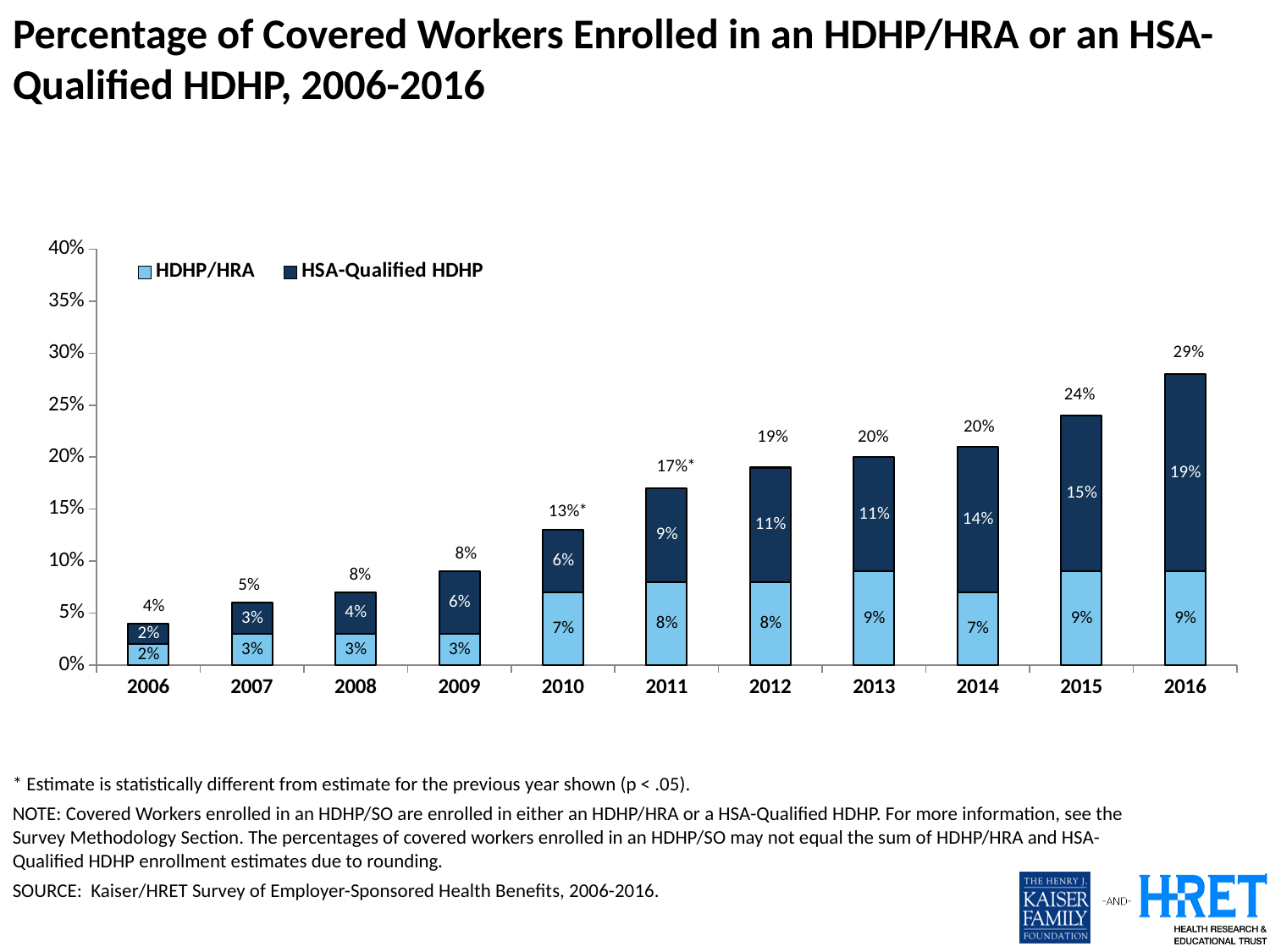
Which year has the lowest total enrollment? 2006 How many series does the legend list? 2 What is the HSA-Qualified HDHP value for 2016? 19% What is the difference between the HSA-Qualified HDHP value in 2016 and in 2015? 4% How many years are shown on the x axis? 11 Do the total enrollment values generally rise or fall from 2006 to 2016? rise What is the HDHP/HRA value for 2014? 7% In 2012, which is larger: the HDHP/HRA value or the HSA-Qualified HDHP value? HSA-Qualified HDHP Which year has the highest total enrollment? 2016 What type of chart is shown on the slide? stacked bar chart What is the total percentage of covered workers enrolled in an HDHP/HRA or HSA-Qualified HDHP in 2015, as labeled above the bar? 24% Which series is shown in the darker blue colour? HSA-Qualified HDHP